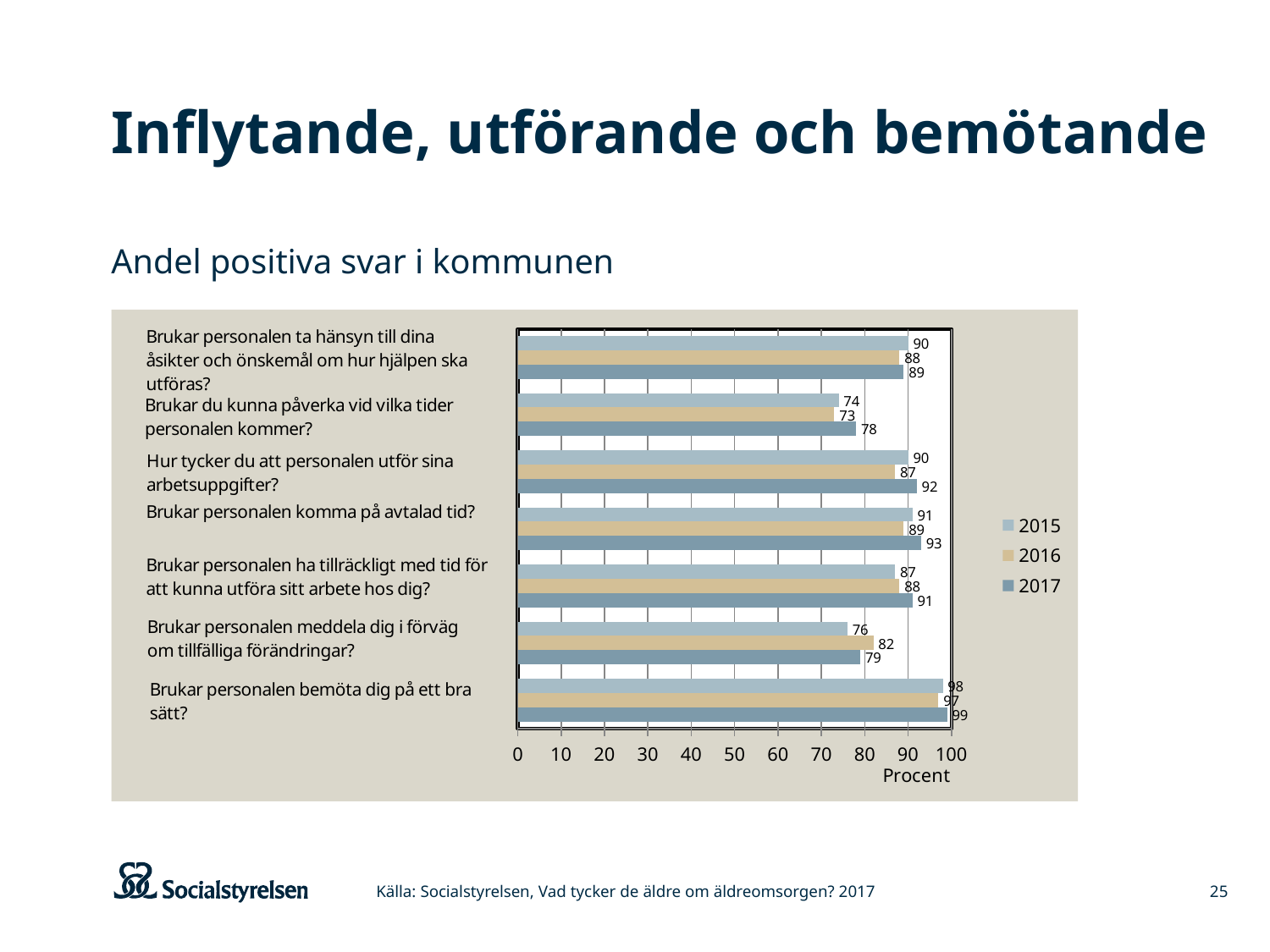
What is the 2015 value for "Brukar personalen komma på avtalad tid?"? 91 What is the 2016 value for "Brukar personalen meddela dig i förväg om tillfälliga förändringar?"? 82 What kind of chart is shown on the slide? Bar chart Is the 2015 value for "Brukar personalen meddela dig i förväg om tillfälliga förändringar?" greater or less than 80? less What is the difference between the 2017 and 2015 values for "Brukar personalen ha tillräckligt med tid för att kunna utföra sitt arbete hos dig?"? 4 What is the 2017 value for "Brukar du kunna påverka vid vilka tider personalen kommer?"? 78 Which category has the lowest 2016 value? Brukar du kunna påverka vid vilka tider personalen kommer? What is the label of the horizontal axis? Procent For "Hur tycker du att personalen utför sina arbetsuppgifter?", which year has the larger value, 2016 or 2017? 2017 How many categories (questions) are shown in the chart? 7 How many series does the legend list? 3 Which category has the highest 2017 value? Brukar personalen bemöta dig på ett bra sätt?